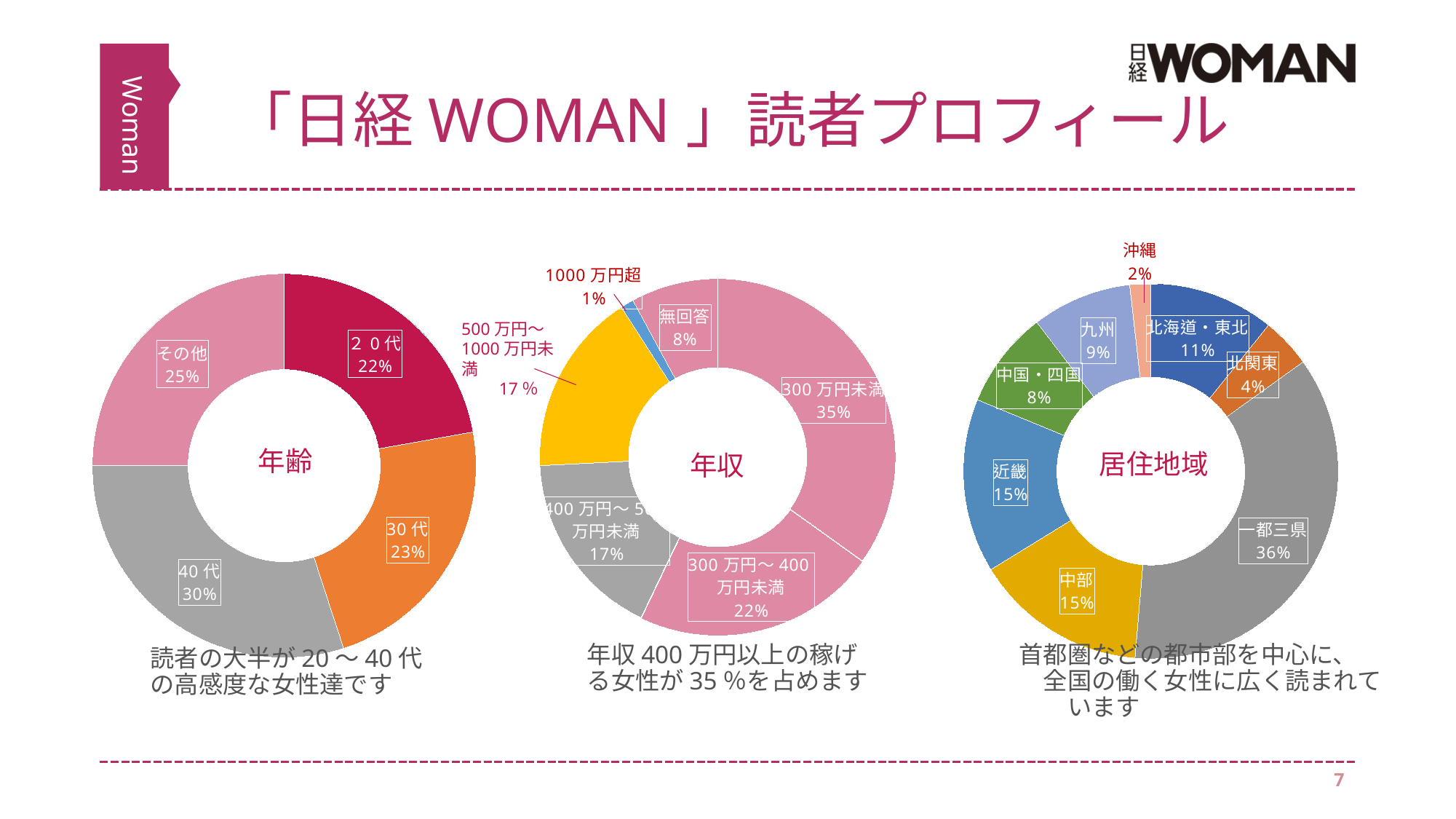
In the 年収 chart, what share is 300万円未満? 35% In the 年収 chart, which category has the smallest share? 1000万円超 In the 年齢 chart, which age group has the largest share? 40代 How many categories does the 年収 chart show? 6 In the 年収 chart, what share is 無回答? 8% In the 年齢 chart, what share of readers are 40代? 30% In the 年齢 chart, what is the difference between the 40代 share and the 20代 share? 8% What kind of chart is the 年齢 chart on the left? Donut (pie) chart In the 居住地域 chart, what share of readers live in 一都三県? 36% In the 年齢 chart, which category has the smallest share? 20代 In the 居住地域 chart, which is larger, 北海道・東北 or 九州? 北海道・東北 How many regions does the 居住地域 chart show? 8